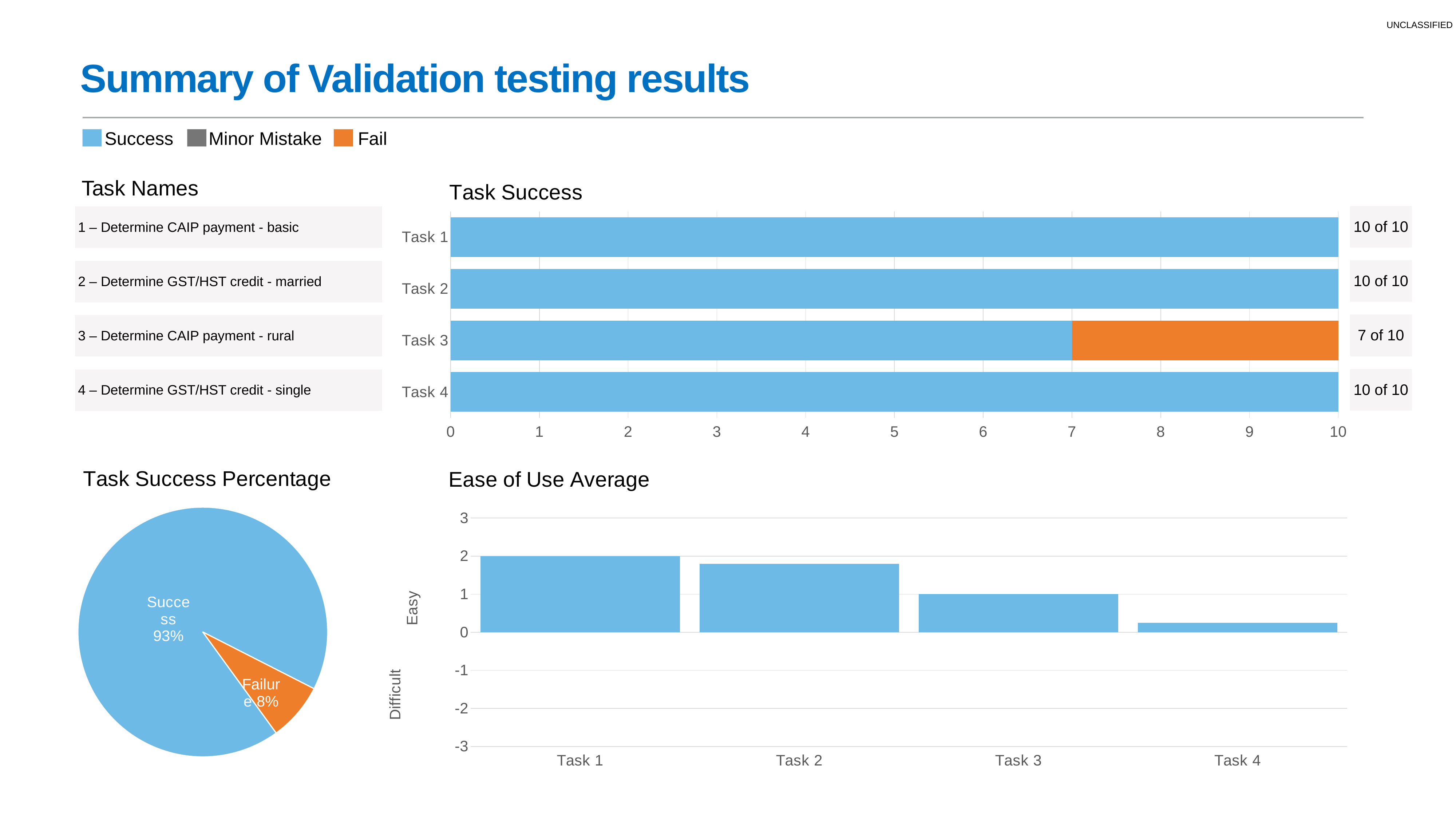
What kind of chart is the Task Success chart? bar chart In the Ease of Use Average chart, do the values rise or fall from Task 1 to Task 4? fall In the Task Success chart, what is the value shown for Task 3? 7 of 10 How many tasks are plotted in the Task Success chart? 4 In the Task Success chart, what is the value shown for Task 1? 10 of 10 In the Task Success Percentage pie chart, what share is Failure? 8% In the Task Success Percentage pie chart, what share is Success? 93% How many slices does the Task Success Percentage pie chart have? 2 In the Ease of Use Average chart, which task has the lowest value? Task 4 In the Ease of Use Average chart, is the value for Task 2 greater or less than 1? greater In the Task Success chart, which task has the lowest success count? Task 3 How many entries does the legend at the top of the slide list? 3